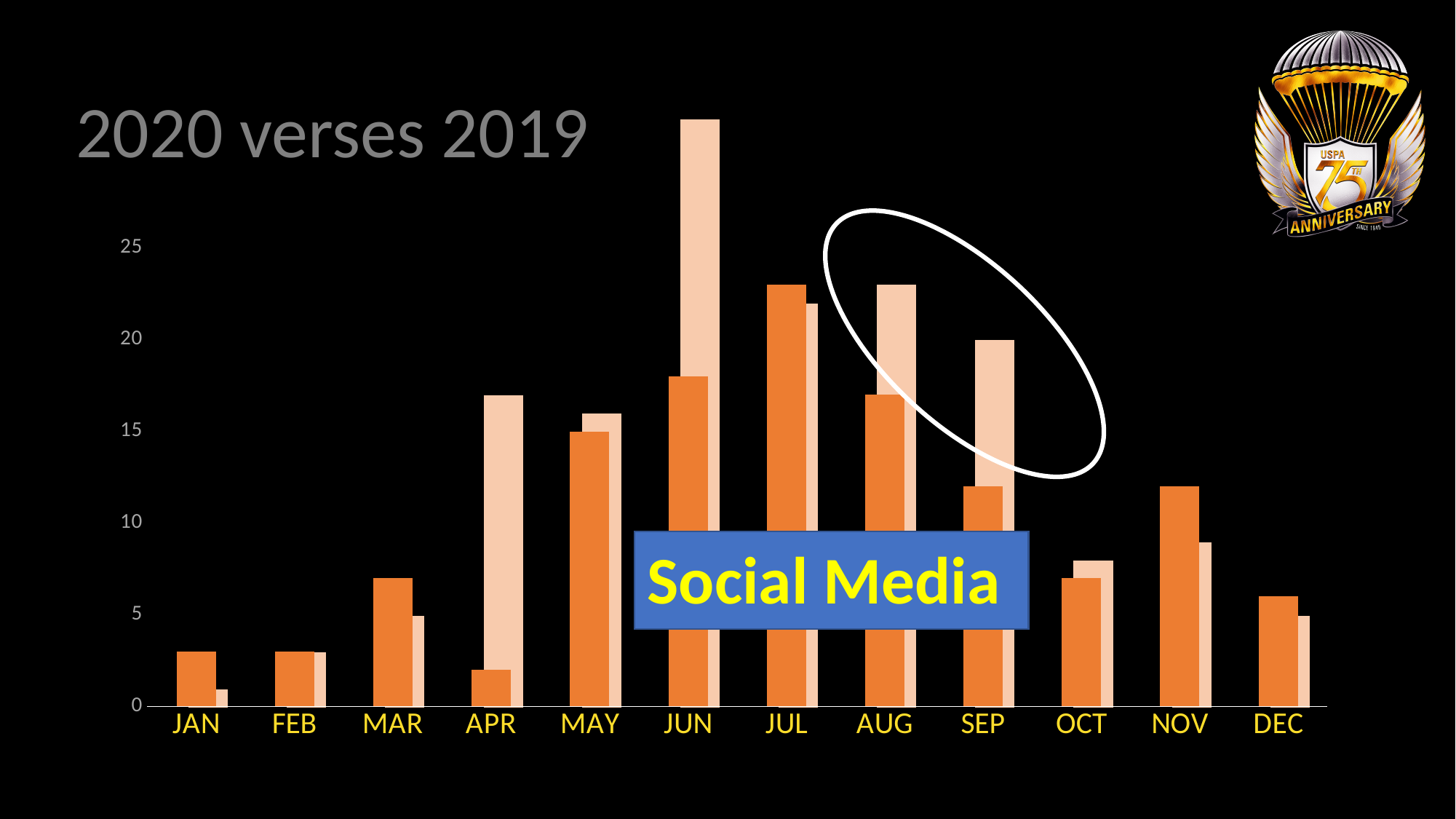
In NOV, which bar is taller, the dark orange bar or the light orange bar? the dark orange bar Is the dark orange bar for JUL greater or less than 20? greater Is the dark orange bar for JAN greater or less than 5? less What is the title of the chart? 2020 verses 2019 Which month has the tallest dark orange bar? JUL What text appears in the blue box overlaid on the chart? Social Media Which month has the tallest light orange bar? JUN Is the light orange bar for APR greater or less than 15? greater In APR, which bar is taller, the dark orange bar or the light orange bar? the light orange bar What kind of chart is shown on the slide? bar chart How many months are shown along the x axis of the chart? 12